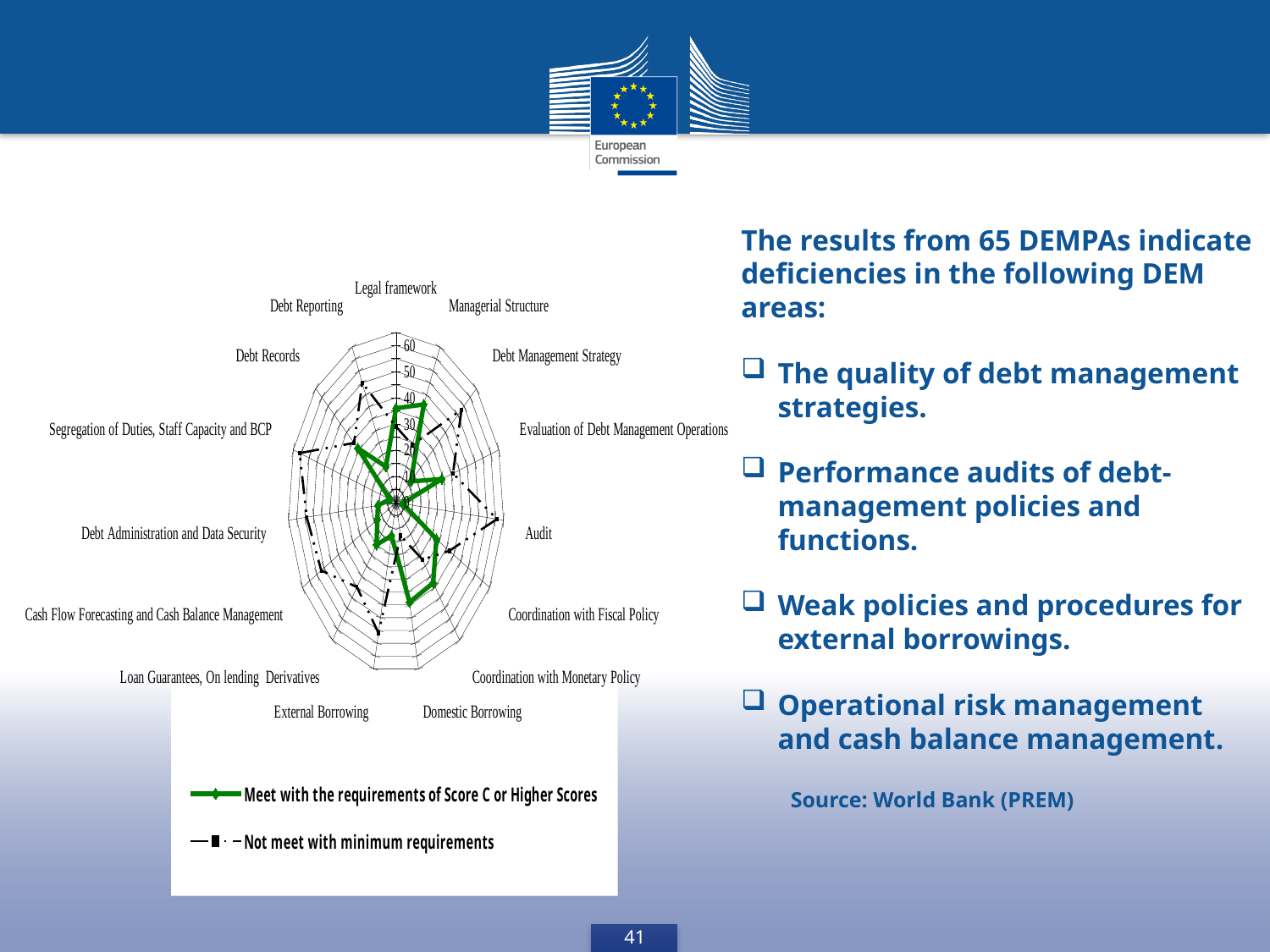
For Segregation of Duties, Staff Capacity and BCP, which series has the larger value: 'Meet with the requirements of Score C or Higher Scores' or 'Not meet with minimum requirements'? Not meet with minimum requirements How many categories (axes) does the radar chart have? 15 Which series is drawn with the solid green line? Meet with the requirements of Score C or Higher Scores What kind of chart is shown on the slide? Radar chart For Coordination with Fiscal Policy, which series has the larger value: 'Meet with the requirements of Score C or Higher Scores' or 'Not meet with minimum requirements'? Not meet with minimum requirements Is the 'Not meet with minimum requirements' value for Cash Flow Forecasting and Cash Balance Management greater or less than 30? greater How many series does the chart's legend list? 2 Is the 'Meet with the requirements of Score C or Higher Scores' value for Debt Administration and Data Security greater or less than 30? less What is the highest value shown on the chart's radial axis? 60 Is the 'Not meet with minimum requirements' value for Segregation of Duties, Staff Capacity and BCP greater or less than 40? greater